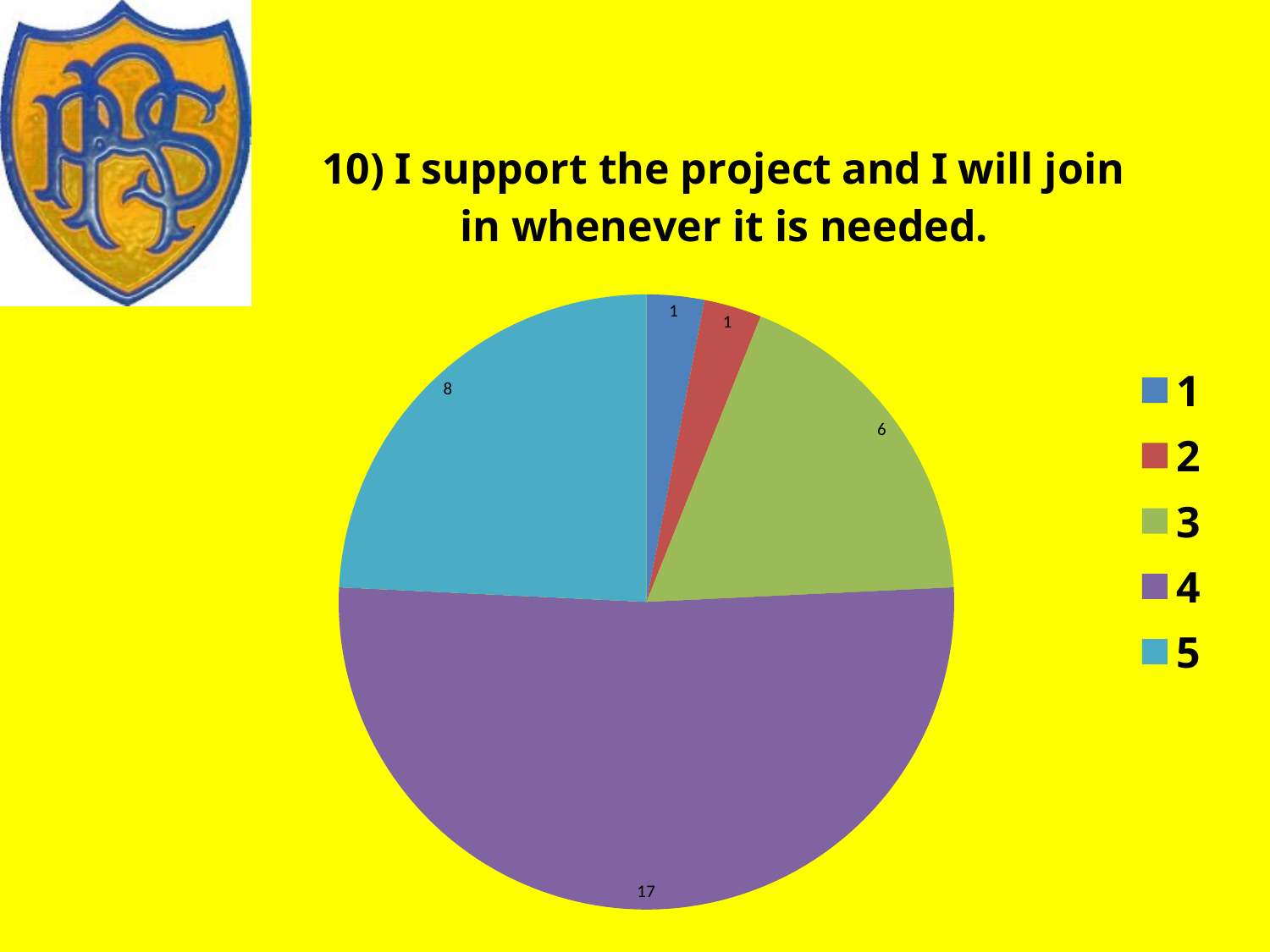
How many entries does the legend list? 5 What colour is the slice for category 4? purple What is the value for category 2? 1 What is the difference between the values for category 4 and category 5? 9 What is the value for category 3? 6 Which is larger, the value for category 5 or the value for category 3? 5 What is the value for category 4? 17 What is the value for category 5? 8 What is the total of all the values in the pie chart? 33 How many slices does the pie chart have? 5 What type of chart is shown on the slide? pie chart Which category has the largest slice of the pie? 4